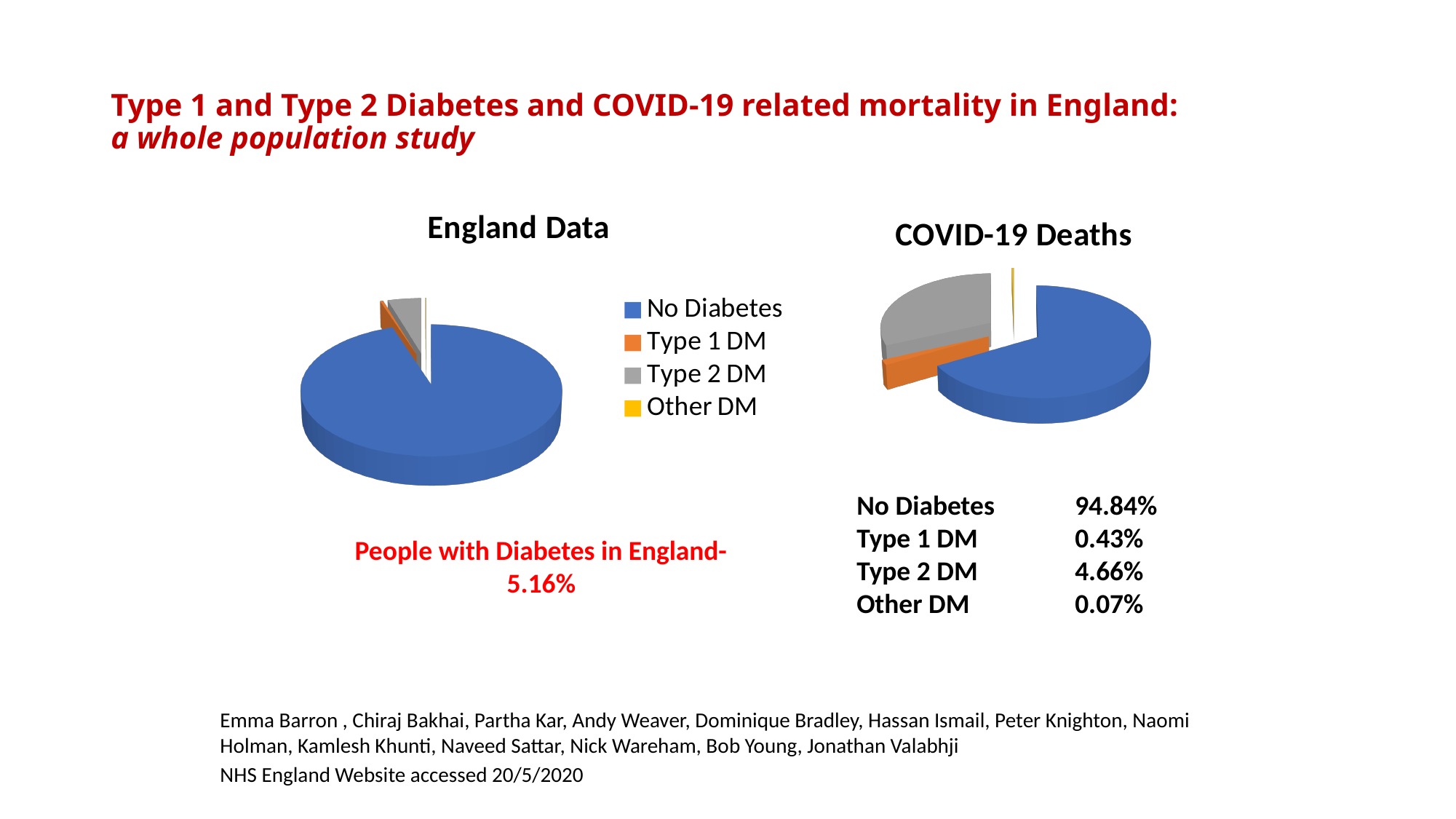
In the "COVID-19 Deaths" chart, which is larger, Type 1 DM or Type 2 DM? Type 2 DM How many categories does the legend list for the pie charts? 4 In the "COVID-19 Deaths" chart, which category has the smallest share? Other DM What kind of chart is the "England Data" chart? pie chart What kind of chart is the "COVID-19 Deaths" chart? pie chart In the "COVID-19 Deaths" chart, which category has the largest share? No Diabetes According to the "England Data" chart, what share of people in England have diabetes? 5.16%